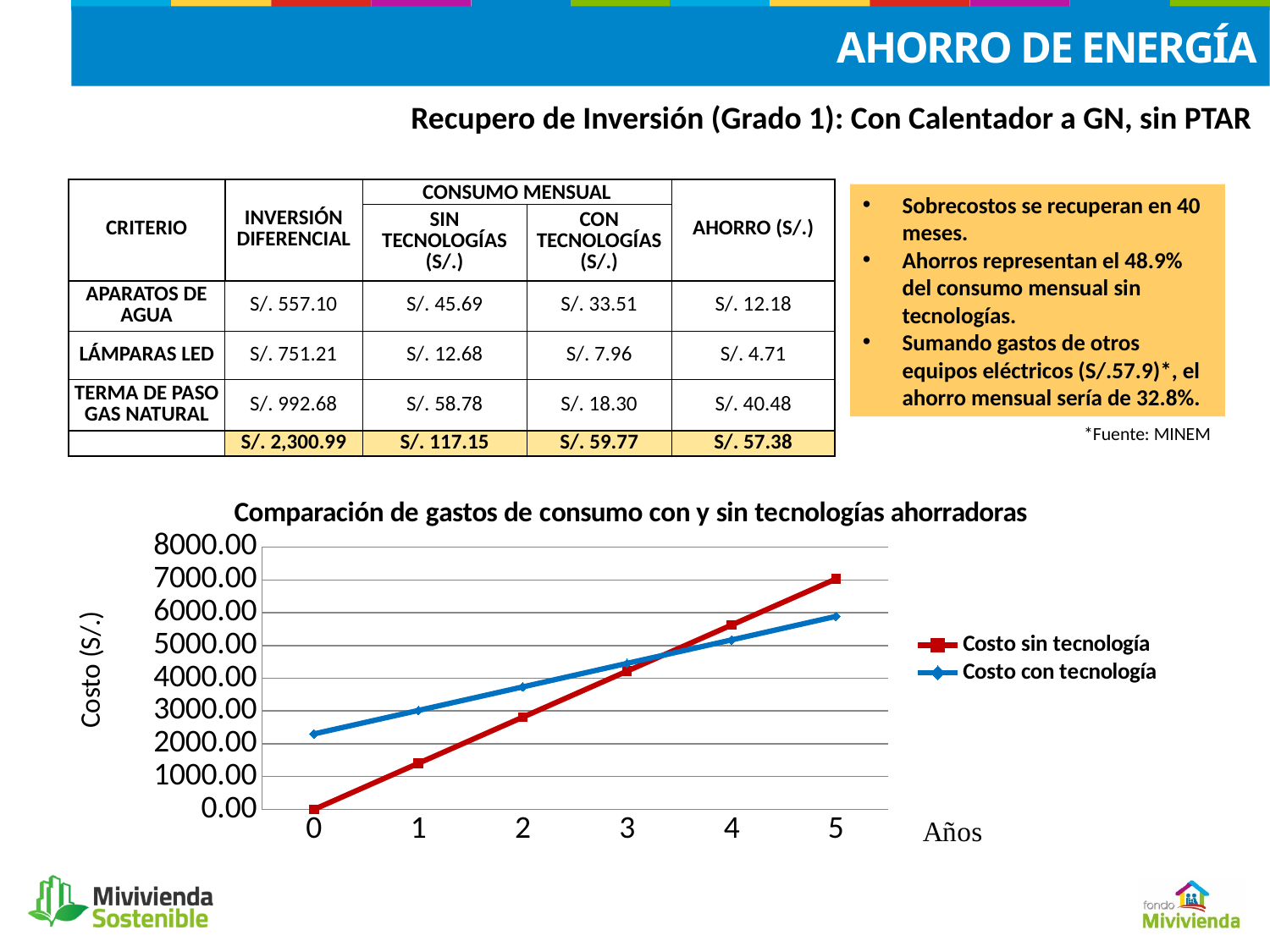
Is the value of Costo sin tecnología at year 5 greater or less than 6000.00? greater How many series does the chart legend list? 2 How many points are plotted for the Costo sin tecnología series? 6 Is the value of Costo con tecnología at year 2 greater or less than 4000.00? less At year 5, which series has the higher value, Costo sin tecnología or Costo con tecnología? Costo sin tecnología Do the values of Costo sin tecnología rise or fall as the years increase? rise What is the title of the chart? Comparación de gastos de consumo con y sin tecnologías ahorradoras What is the value of Costo sin tecnología at year 0? 0.00 What kind of chart is shown on the slide? line chart Is the value of Costo con tecnología at year 0 greater or less than 2000.00? greater At year 1, which series has the higher value, Costo sin tecnología or Costo con tecnología? Costo con tecnología